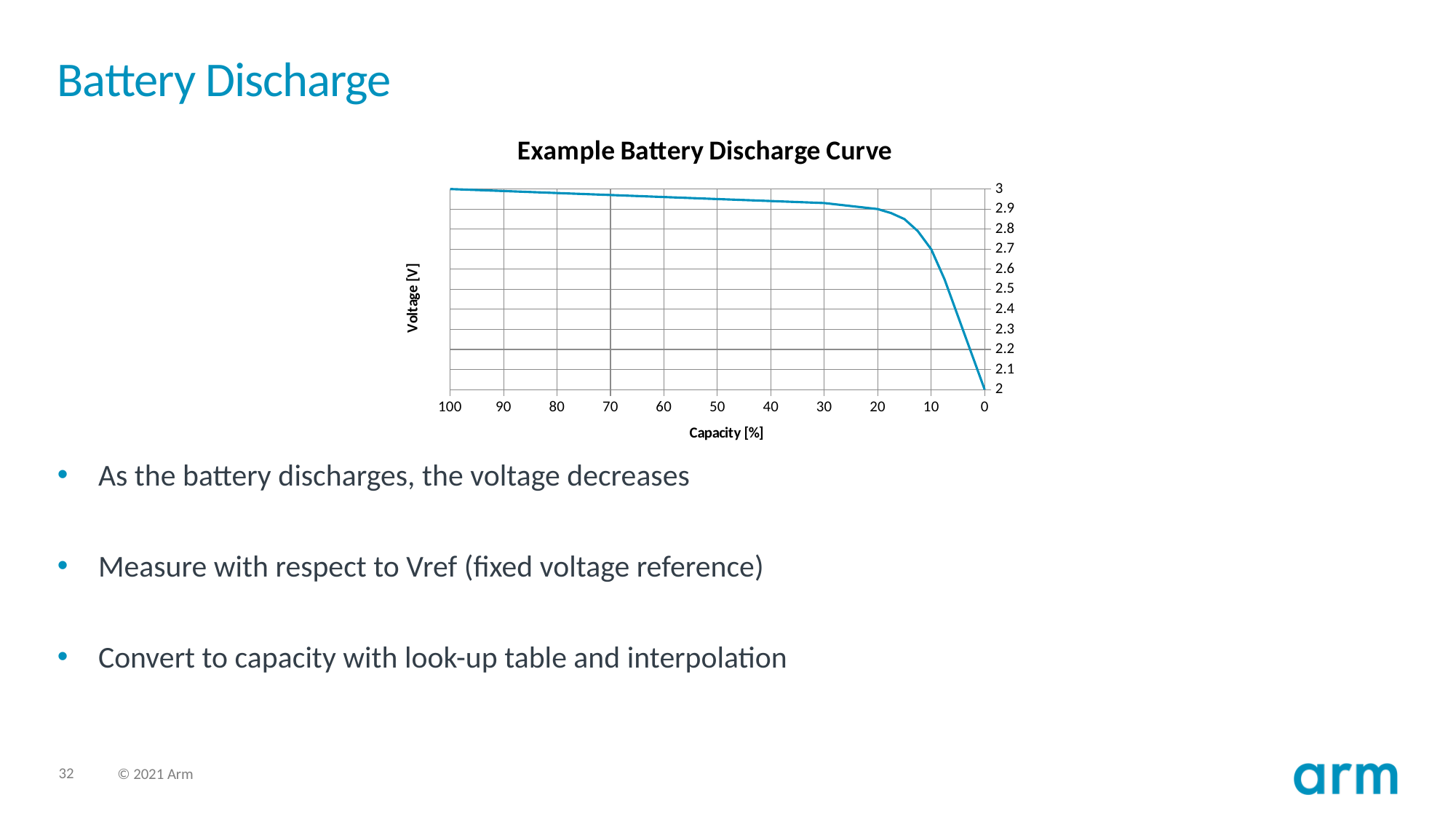
Which has the higher voltage: 90% capacity or 10% capacity? 90% capacity What is the label of the vertical axis of the chart? Voltage [V] Is the voltage at 80% capacity greater or less than 2.9? greater Is the voltage at 50% capacity greater or less than 2.8? greater What is the title of the chart? Example Battery Discharge Curve Does the voltage rise or fall as capacity goes from 100% to 0% along the x axis? fall What is the voltage at 100% capacity? 3 Is the voltage at 5% capacity greater or less than 2.6? less How many capacity tick labels are shown on the x axis? 11 What type of chart is shown on the slide? line chart What is the voltage at 0% capacity? 2